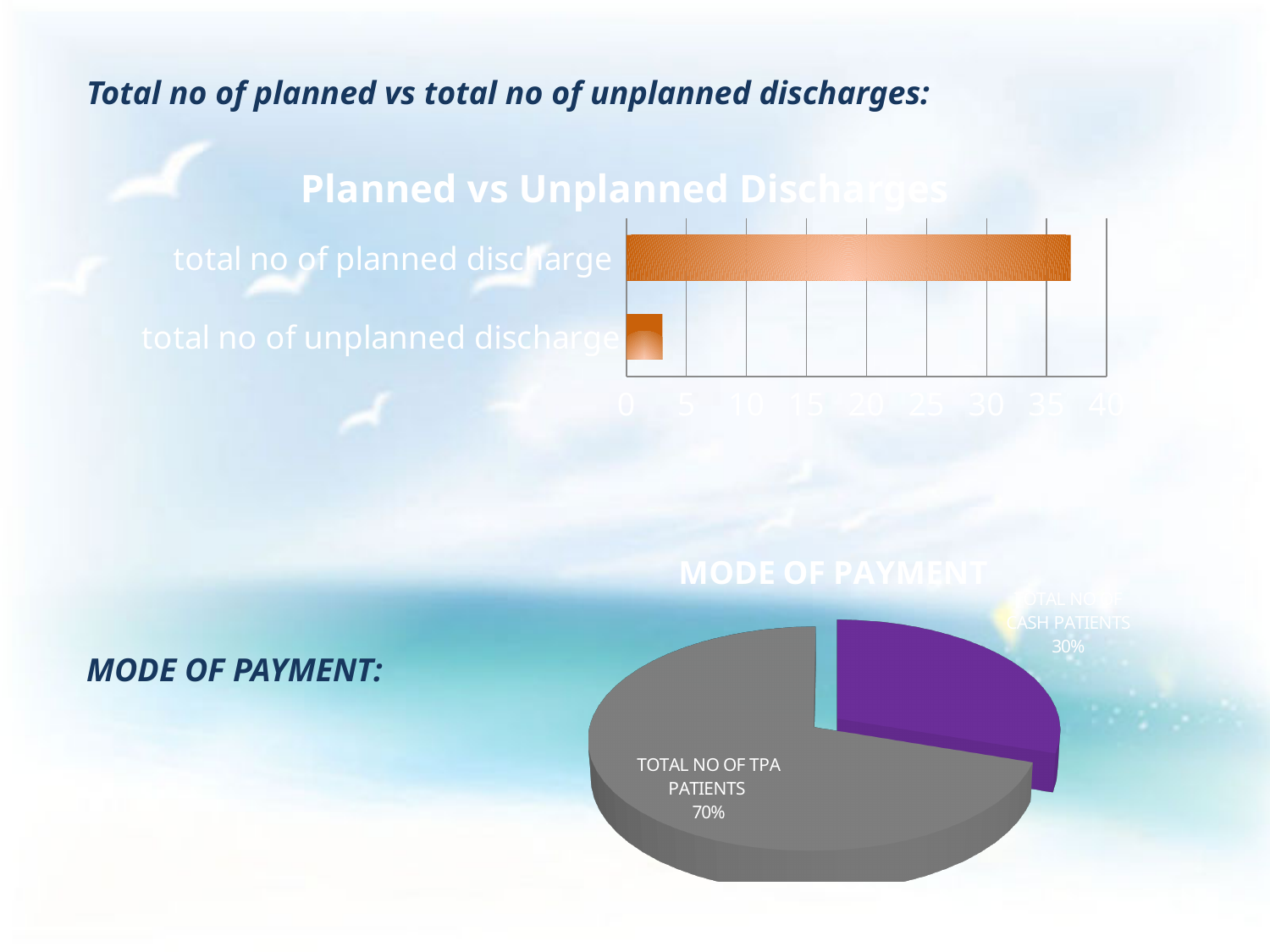
In the 'Planned vs Unplanned Discharges' chart, is the value for total no of unplanned discharge greater or less than 5? less In the 'Planned vs Unplanned Discharges' chart, is the value for total no of planned discharge greater or less than 30? greater In the 'Planned vs Unplanned Discharges' chart, which category has the highest value? total no of planned discharge In the 'Planned vs Unplanned Discharges' chart, what is the maximum value shown on the horizontal axis? 40 In the 'Planned vs Unplanned Discharges' chart, which category has the lowest value? total no of unplanned discharge In the 'Planned vs Unplanned Discharges' chart, how many categories are plotted? 2 In the 'MODE OF PAYMENT' chart, what share of the pie is TOTAL NO OF CASH PATIENTS? 30% In the 'Planned vs Unplanned Discharges' chart, what kind of chart is shown? bar chart In the 'MODE OF PAYMENT' chart, which slice is the largest? TOTAL NO OF TPA PATIENTS In the 'MODE OF PAYMENT' chart, what share of the pie is TOTAL NO OF TPA PATIENTS? 70% In the 'MODE OF PAYMENT' chart, what kind of chart is shown? pie chart In the 'Planned vs Unplanned Discharges' chart, which is larger: total no of planned discharge or total no of unplanned discharge? total no of planned discharge